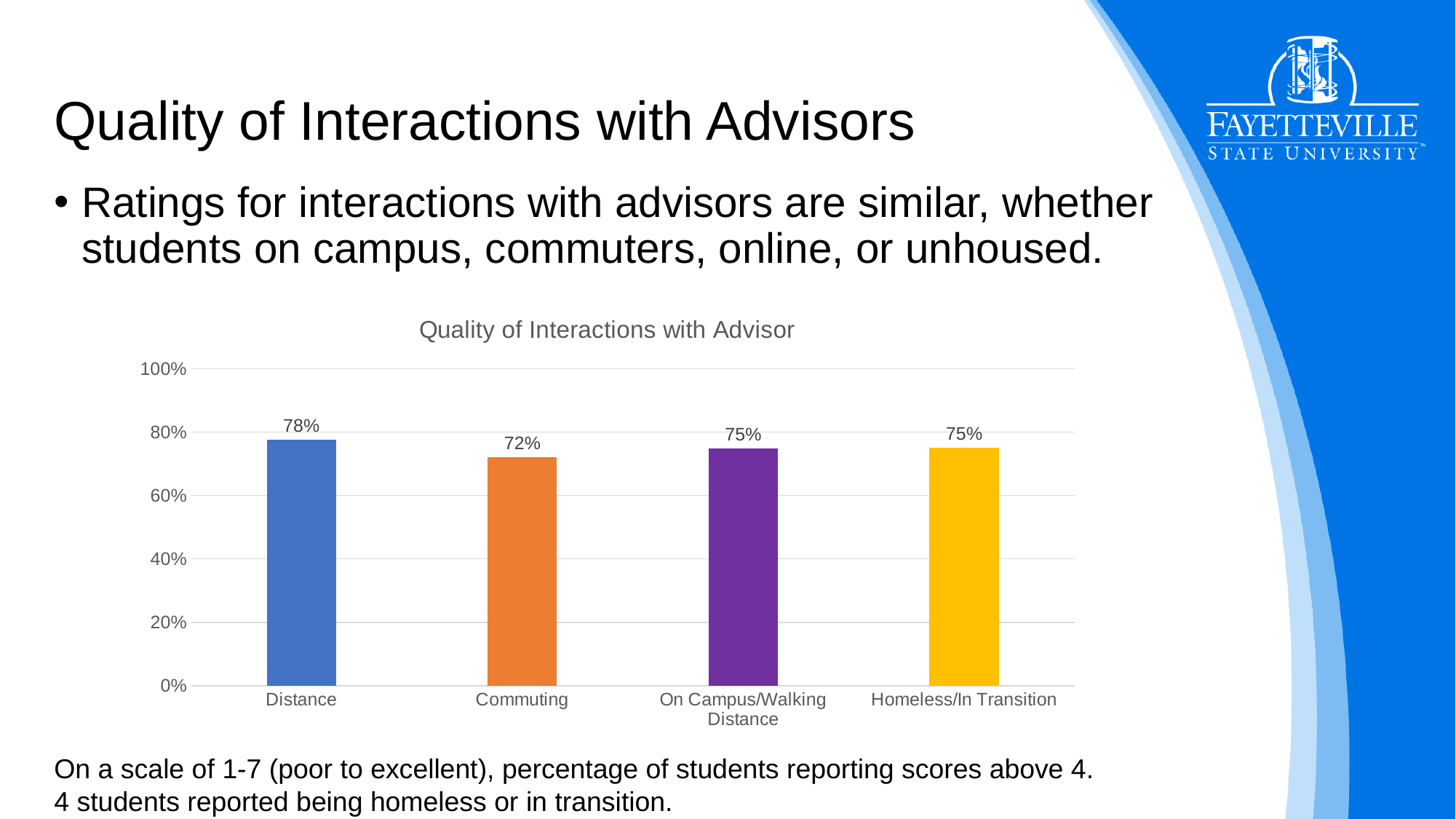
Is the value for Commuting greater or less than 80%? less What is the value for Homeless/In Transition? 75% What is the value for Distance? 78% What is the value for On Campus/Walking Distance? 75% What is the title of the chart? Quality of Interactions with Advisor What kind of chart is shown on the slide? bar chart How many categories are shown on the x axis? 4 Which category has the lowest value? Commuting Which is larger, the value for Distance or the value for On Campus/Walking Distance? Distance Which category has the highest value? Distance What is the value for Commuting? 72% What is the difference between the values for Distance and Commuting? 6%